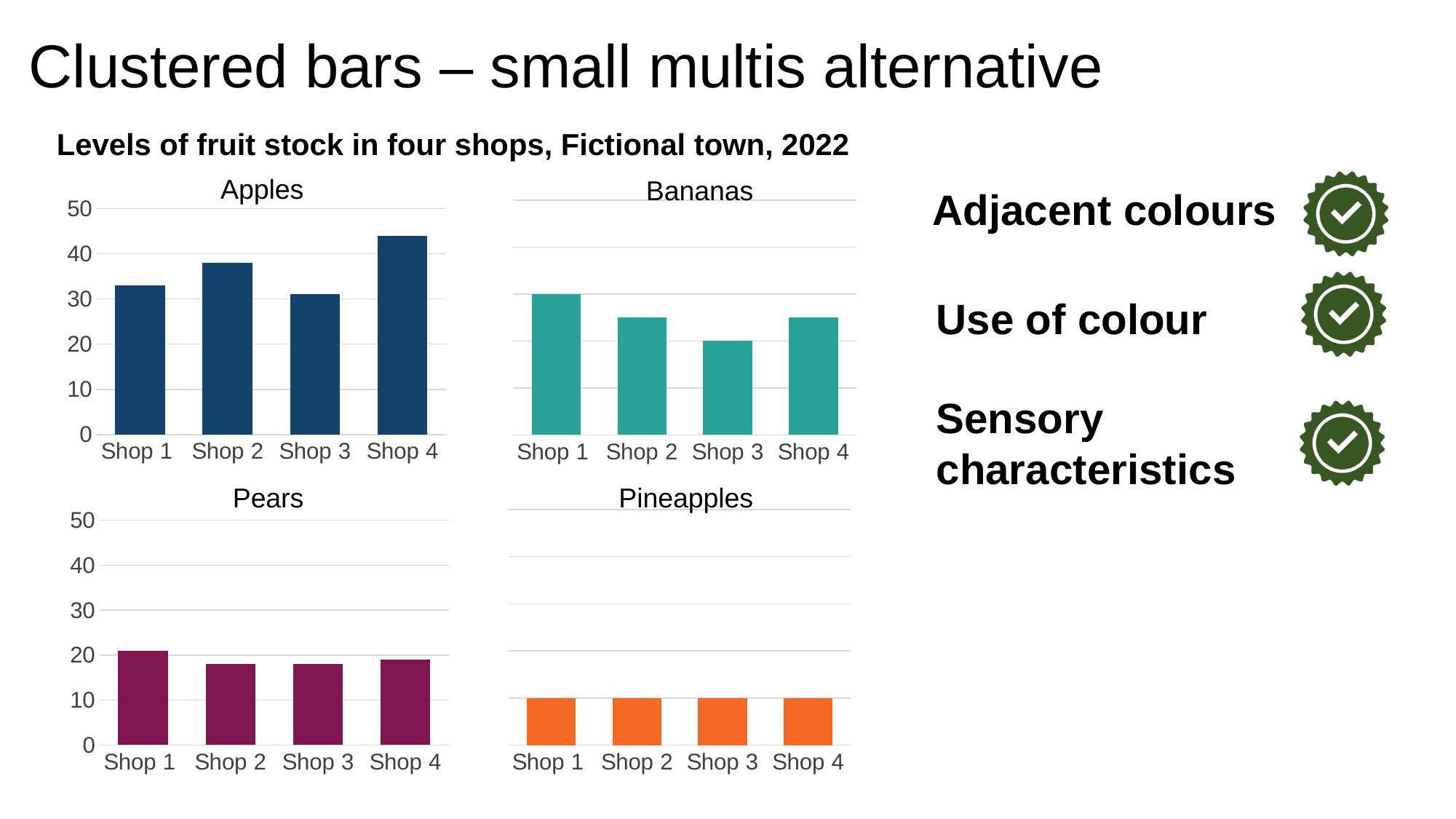
In the Bananas chart, which is larger, the value for Shop 1 or the value for Shop 3? Shop 1 What is the overall title above the four charts? Levels of fruit stock in four shops, Fictional town, 2022 How many shops are shown on the x axis of the Pears chart? 4 What kind of chart is the Pineapples chart? bar chart In the Apples chart, which is larger, the value for Shop 2 or the value for Shop 3? Shop 2 In the Bananas chart, which shop has the lowest level of stock? Shop 3 In the Pineapples chart, do the values rise, fall or stay the same across the shops? stay the same In the Pears chart, is the value for Shop 2 greater or less than 20? less In the Apples chart, is the value for Shop 1 greater or less than 30? greater In the Bananas chart, which shop has the highest level of stock? Shop 1 In the Apples chart, which shop has the highest level of stock? Shop 4 In the Apples chart, is the value for Shop 4 greater or less than 40? greater